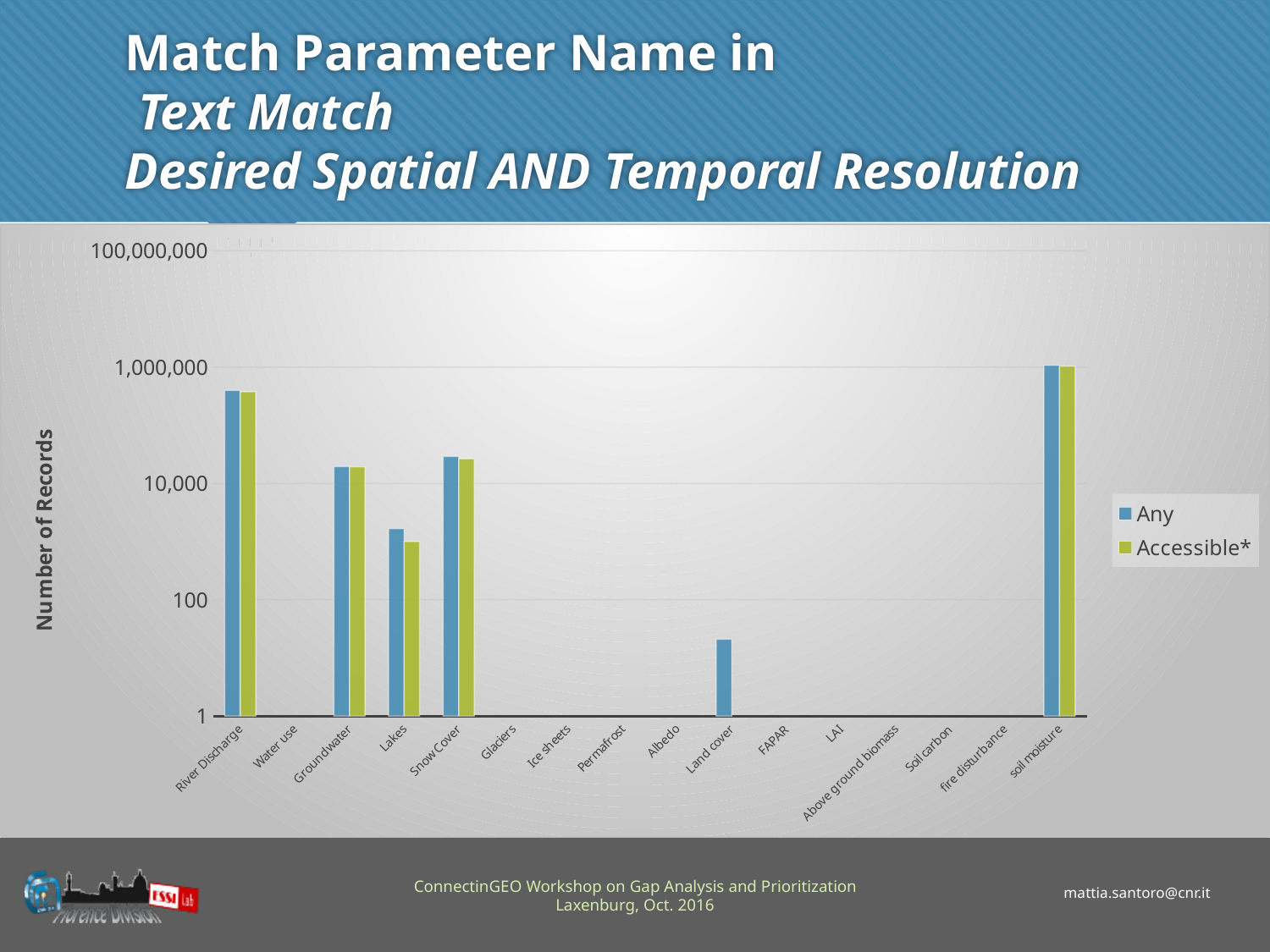
Which category has the highest value for the Any series? soil moisture For Lakes, which series has the larger value, Any or Accessible*? Any Which is larger, the Any value for River Discharge or the Any value for Groundwater? River Discharge Is the Any value for Lakes greater or less than 10,000? less Among the categories with a visible bar, which has the lowest value for the Any series? Land cover What is the title of the vertical axis? Number of Records Is the Any value for Land cover greater or less than 100? less How many categories are shown along the x axis? 16 Is the Any value for Snow Cover greater or less than 10,000? greater How many series does the legend list? 2 What kind of chart is shown on the slide? bar chart